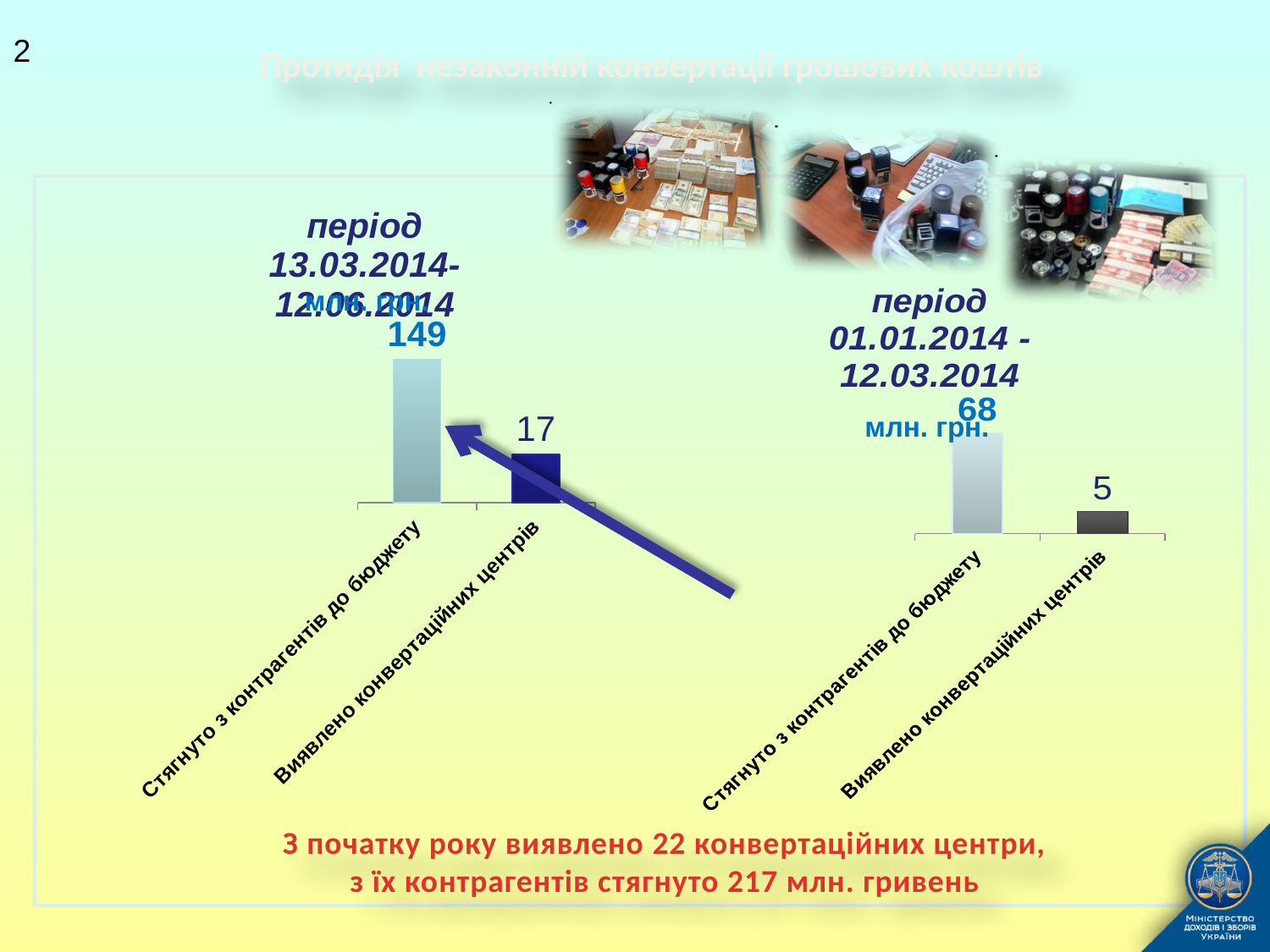
In the right chart (period 01.01.2014 - 12.03.2014), what is the value for "Стягнуто з контрагентів до бюджету"? 68 How many categories does the left chart (period 13.03.2014-12.06.2014) show? 2 In the right chart (period 01.01.2014 - 12.03.2014), what is the difference between the two bars? 63 What type of chart is the right chart (period 01.01.2014 - 12.03.2014)? Bar chart In the left chart (period 13.03.2014-12.06.2014), what is the value for "Стягнуто з контрагентів до бюджету"? 149 In the left chart (period 13.03.2014-12.06.2014), what is the difference between the two bars? 132 In the right chart (period 01.01.2014 - 12.03.2014), which category has the lowest value? Виявлено конвертаційних центрів In the left chart (period 13.03.2014-12.06.2014), which category has the highest value? Стягнуто з контрагентів до бюджету In the right chart (period 01.01.2014 - 12.03.2014), what is the value for "Виявлено конвертаційних центрів"? 5 Which is larger: "Стягнуто з контрагентів до бюджету" in the left chart or in the right chart? Left chart (149) In the left chart (period 13.03.2014-12.06.2014), what is the value for "Виявлено конвертаційних центрів"? 17 What unit is shown for the values in the right chart (period 01.01.2014 - 12.03.2014)? млн. грн.